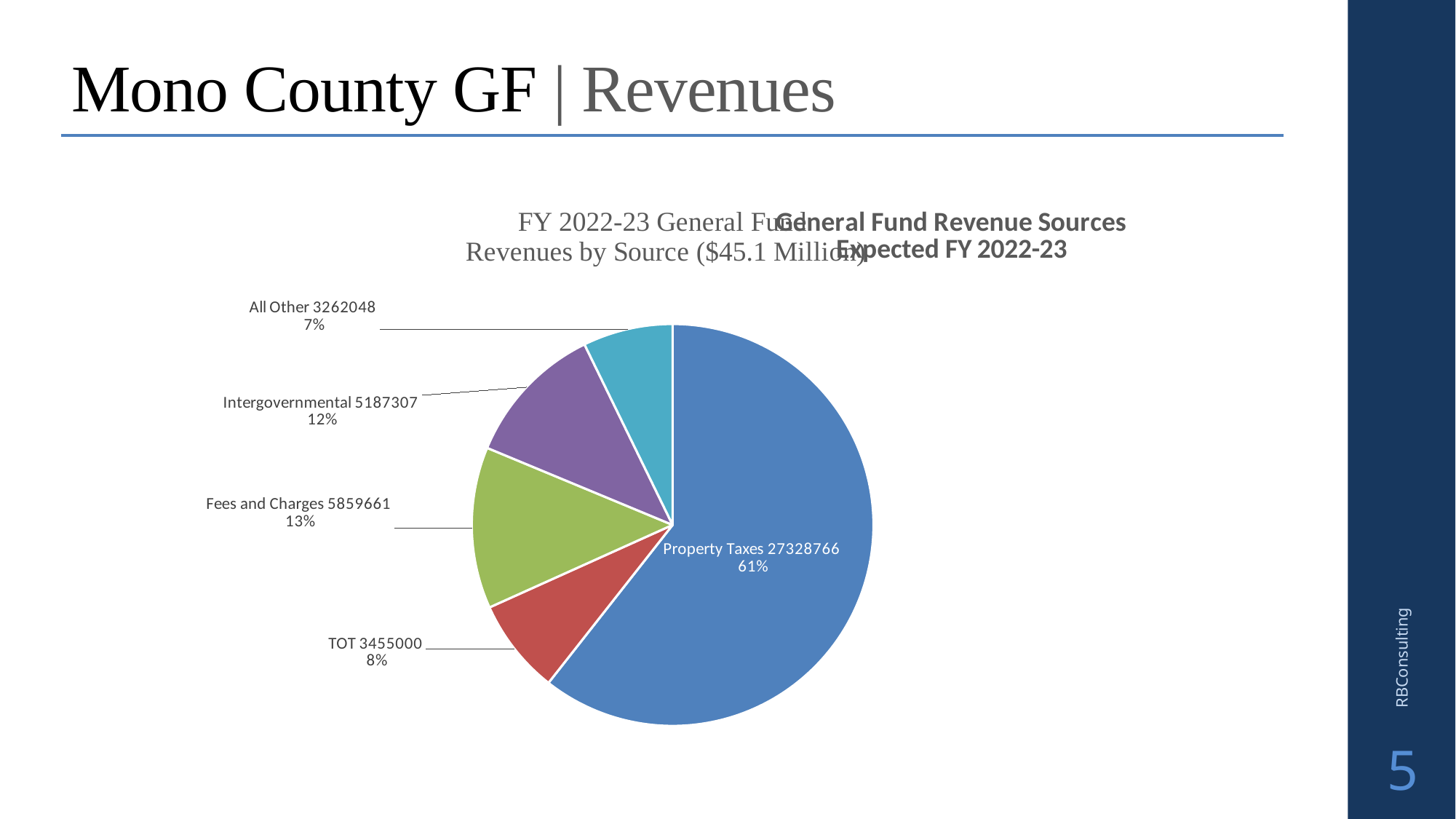
What is the value shown for Intergovernmental? 5187307 What is the value shown for TOT? 3455000 How many revenue source categories does the pie chart show? 5 Which revenue source is the largest slice of the pie? Property Taxes What share of the pie does Property Taxes represent? 61% What is the difference between the Fees and Charges value and the TOT value? 2404661 What type of chart is shown on the slide? pie chart What share of the pie does All Other represent? 7% Which revenue source is the smallest slice of the pie? All Other Which is larger, Fees and Charges or Intergovernmental? Fees and Charges What is the value shown for Fees and Charges? 5859661 What is the value shown for Property Taxes? 27328766